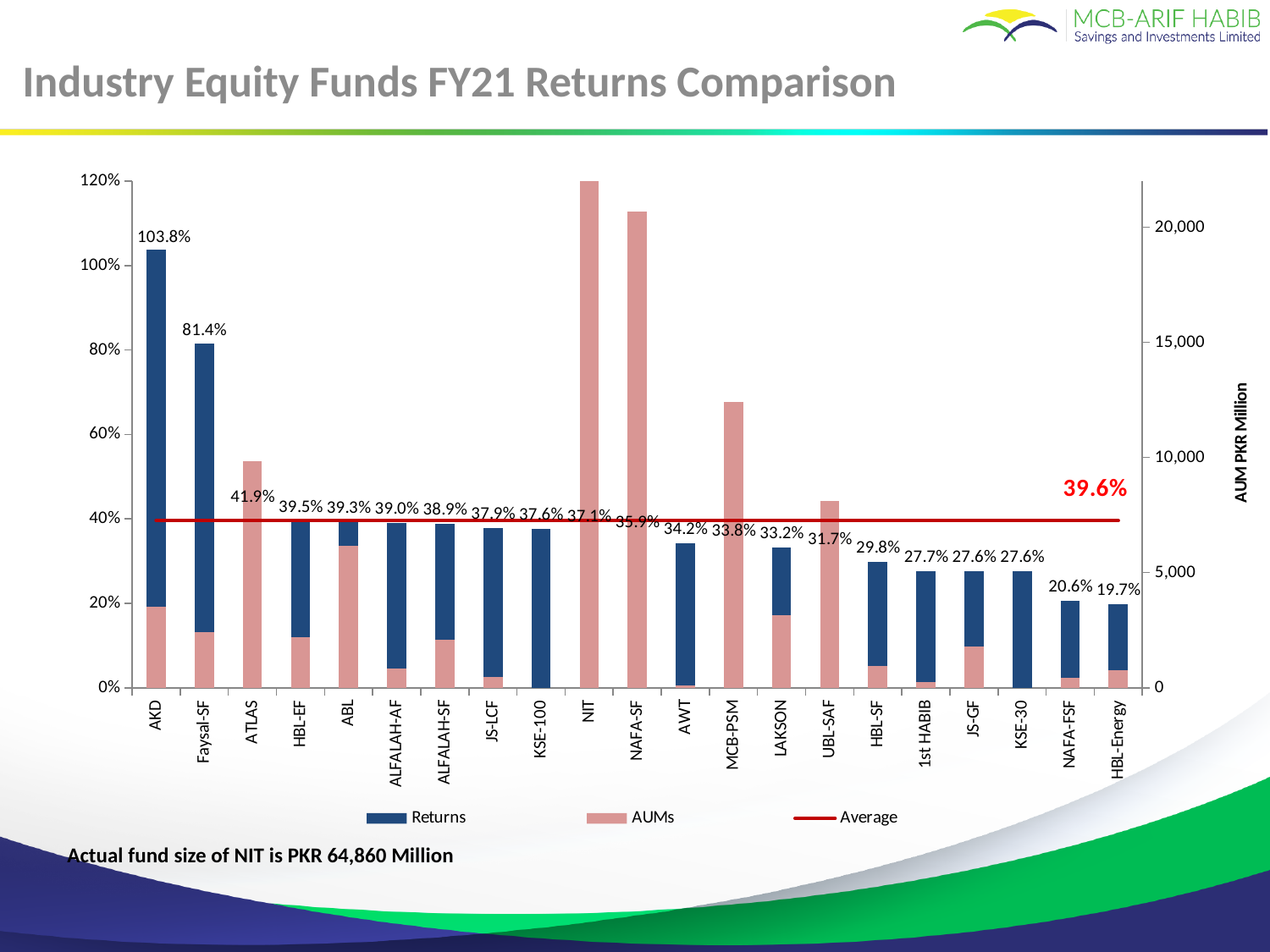
What value does the red Average line represent? 39.6% What is the FY21 return shown for AKD? 103.8% What is the FY21 return shown for NAFA-FSF? 20.6% How many series does the legend list? 3 Is the AUM value for MCB-PSM greater or less than 10,000? greater How many funds/indices are listed along the x axis? 21 Which fund has the lowest return on the chart? HBL-Energy Is the AUM value for UBL-SAF greater or less than 10,000? less What is the FY21 return shown for HBL-Energy? 19.7% Which has the higher return, ATLAS or HBL-EF? ATLAS Which fund has the highest return on the chart? AKD What is the difference between the returns of AKD and Faysal-SF? 22.4 percentage points